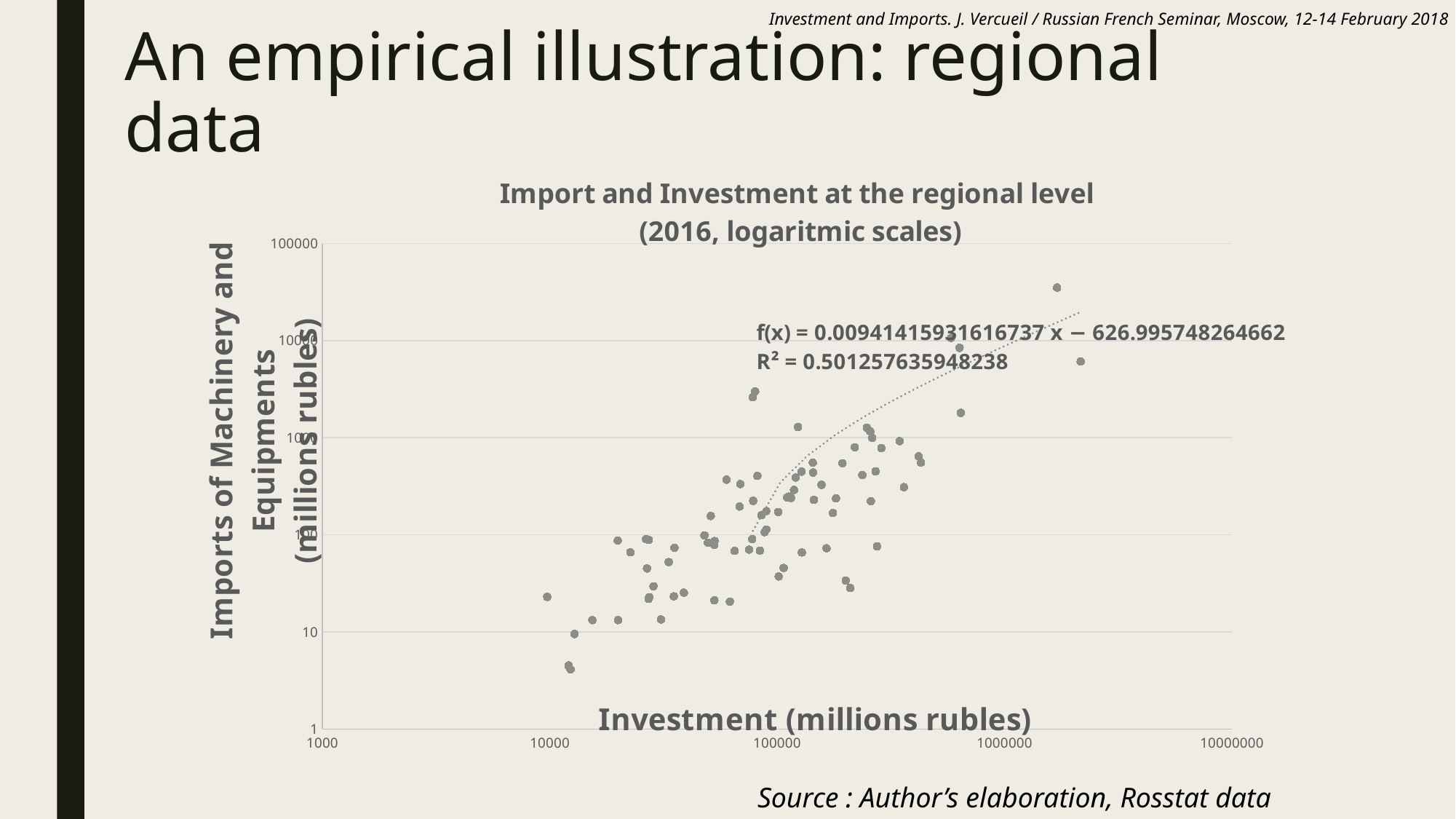
Do imports of machinery and equipment generally rise or fall as investment increases along the x axis? Rise What is the largest tick value shown on the x axis? 10000000 What is the smallest tick value shown on the y axis? 1 What is the slope coefficient in the fitted equation f(x) printed on the chart? 0.00941415931616737 What kind of chart is shown on the slide? Scatter plot Is the imports value of the lowest point on the chart greater or less than 10? less What is the title of the chart? Import and Investment at the regional level (2016, logaritmic scales) What R² value is printed on the chart? R² = 0.501257635948238 What is the constant term in the fitted equation f(x) printed on the chart? −626.995748264662 Is the investment value of the highest point on the chart greater or less than 1000000? greater What is the label of the x axis of the chart? Investment (millions rubles) Is the imports value of the highest point on the chart greater or less than 10000? greater